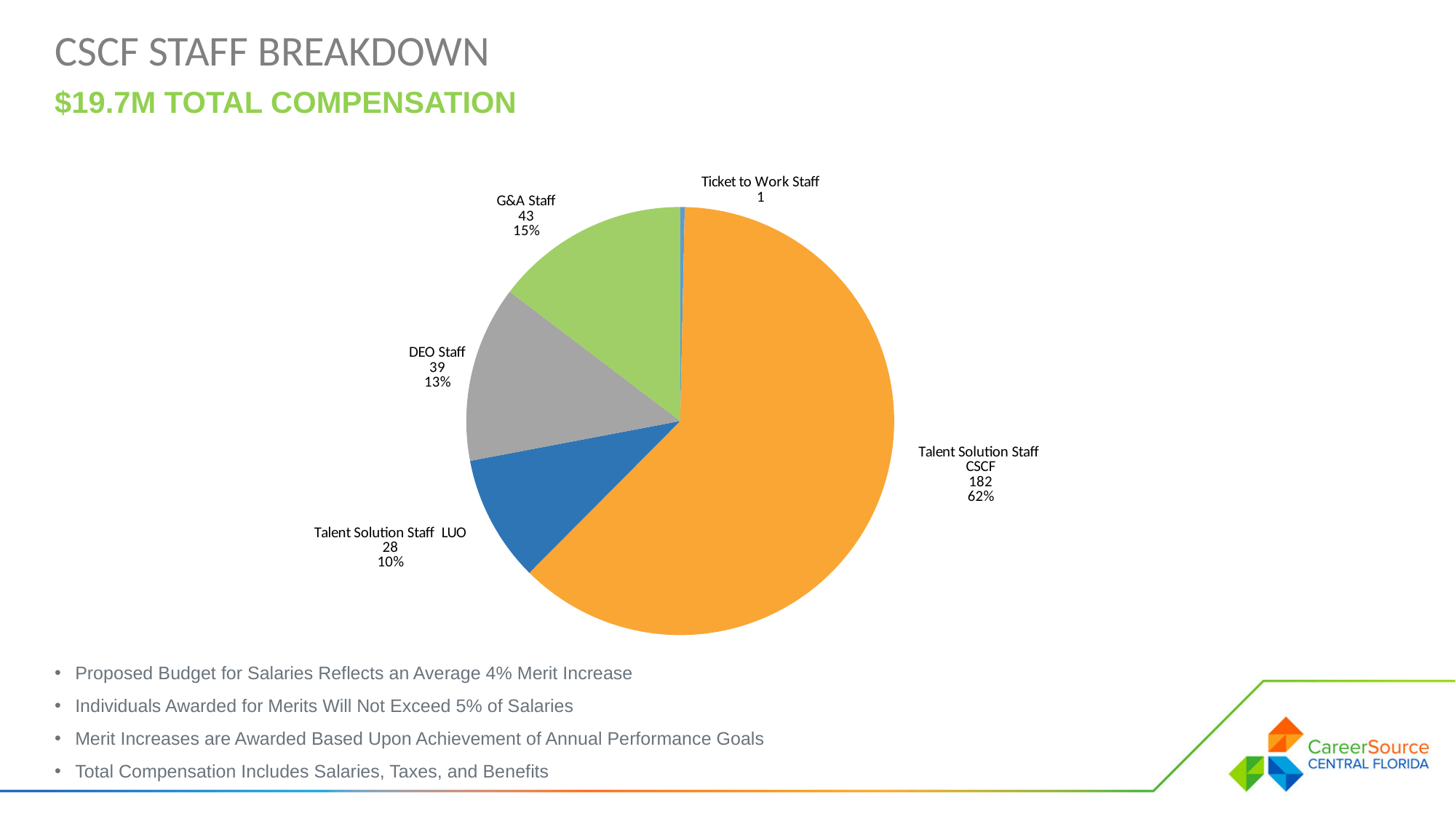
What kind of chart is shown on the slide? Pie chart How many staff are in the Ticket to Work Staff category? 1 What share of the pie does G&A Staff represent? 15% What share of the pie does DEO Staff represent? 13% How many categories are shown in the pie chart? 5 How many staff are in the Talent Solution Staff LUO category? 28 Which category has the largest slice of the pie? Talent Solution Staff CSCF How many staff are in the DEO Staff category? 39 How many staff are in the Talent Solution Staff CSCF category? 182 Which category has the smallest slice of the pie? Ticket to Work Staff How many staff are in the G&A Staff category? 43 What is the difference in staff count between G&A Staff and DEO Staff? 4